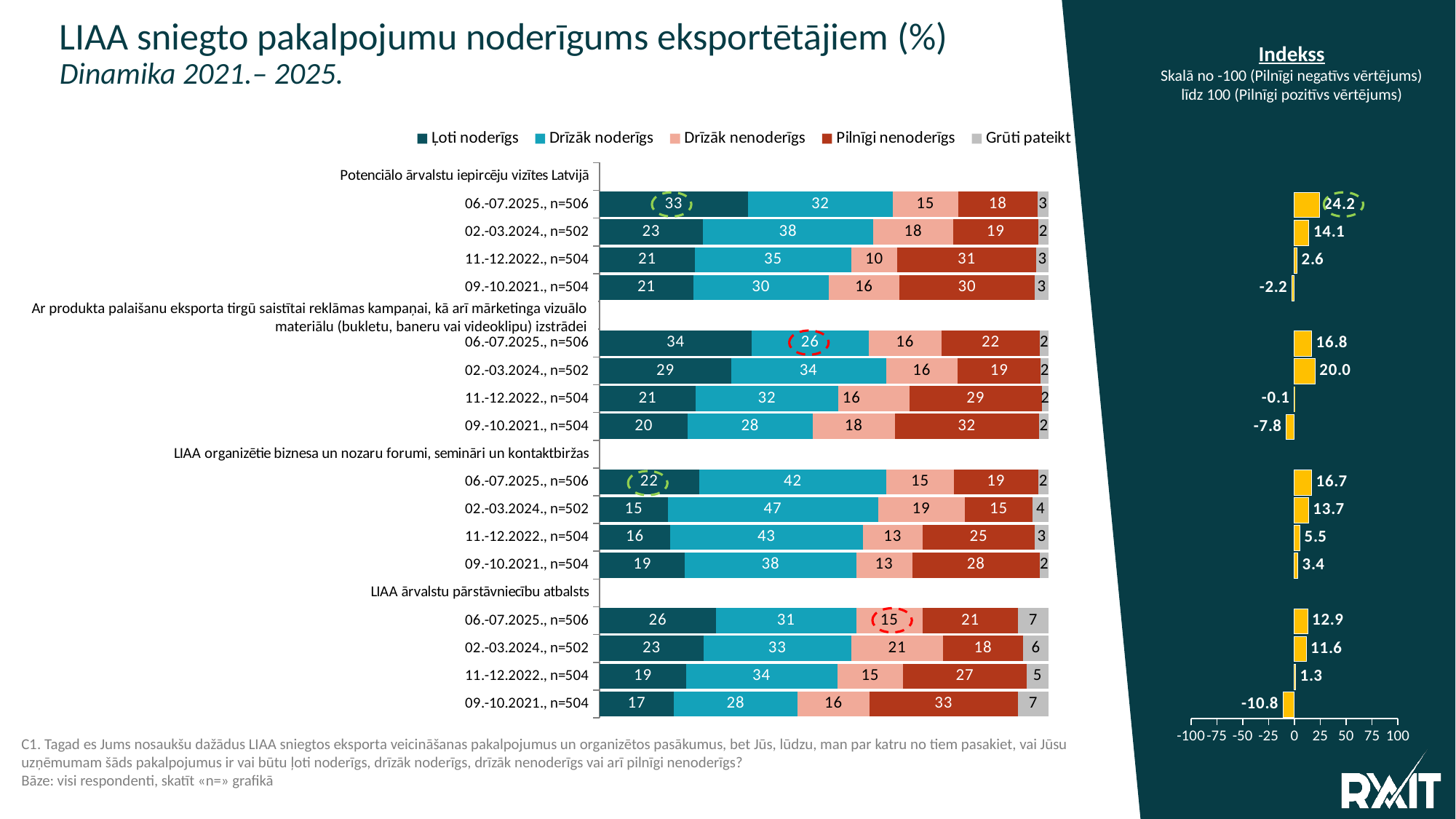
In the 'Indekss' chart, how does the index for 'LIAA organizētie biznesa un nozaru forumi, semināri un kontaktbiržas' change from 09.-10.2021. to 06.-07.2025.? It rises In the stacked bar chart, what percentage of respondents rated 'Potenciālo ārvalstu iepircēju vizītes Latvijā' as 'Ļoti noderīgs' in 06.-07.2025., n=506? 33 What is the range of the scale shown for the 'Indekss' chart? -100 to 100 What kind of chart is used to show the usefulness ratings on the left of the slide? Stacked bar chart In the 'Indekss' chart, which wave has the lowest index value for 'LIAA ārvalstu pārstāvniecību atbalsts'? 09.-10.2021., n=504 In the 'Indekss' chart, which wave has the highest index value for 'Ar produkta palaišanu eksporta tirgū saistītai reklāmas kampaņai...' (the second service)? 02.-03.2024., n=502 How many series does the legend of the stacked bar chart list? 5 In the stacked bar chart, which is larger for 'LIAA ārvalstu pārstāvniecību atbalsts' in 06.-07.2025., n=506: the 'Ļoti noderīgs' value or the 'Drīzāk noderīgs' value? Drīzāk noderīgs In the 'Indekss' chart, what is the index value for 'LIAA ārvalstu pārstāvniecību atbalsts' in 09.-10.2021., n=504? -10.8 In the stacked bar chart, what is the 'Drīzāk noderīgs' value for 'LIAA organizētie biznesa un nozaru forumi, semināri un kontaktbiržas' in 02.-03.2024., n=502? 47 In the 'Indekss' chart, what is the index value for 'Potenciālo ārvalstu iepircēju vizītes Latvijā' in 06.-07.2025., n=506? 24.2 In the stacked bar chart, what is the difference between the 'Pilnīgi nenoderīgs' values for 'Potenciālo ārvalstu iepircēju vizītes Latvijā' in 11.-12.2022., n=504 and 06.-07.2025., n=506? 13